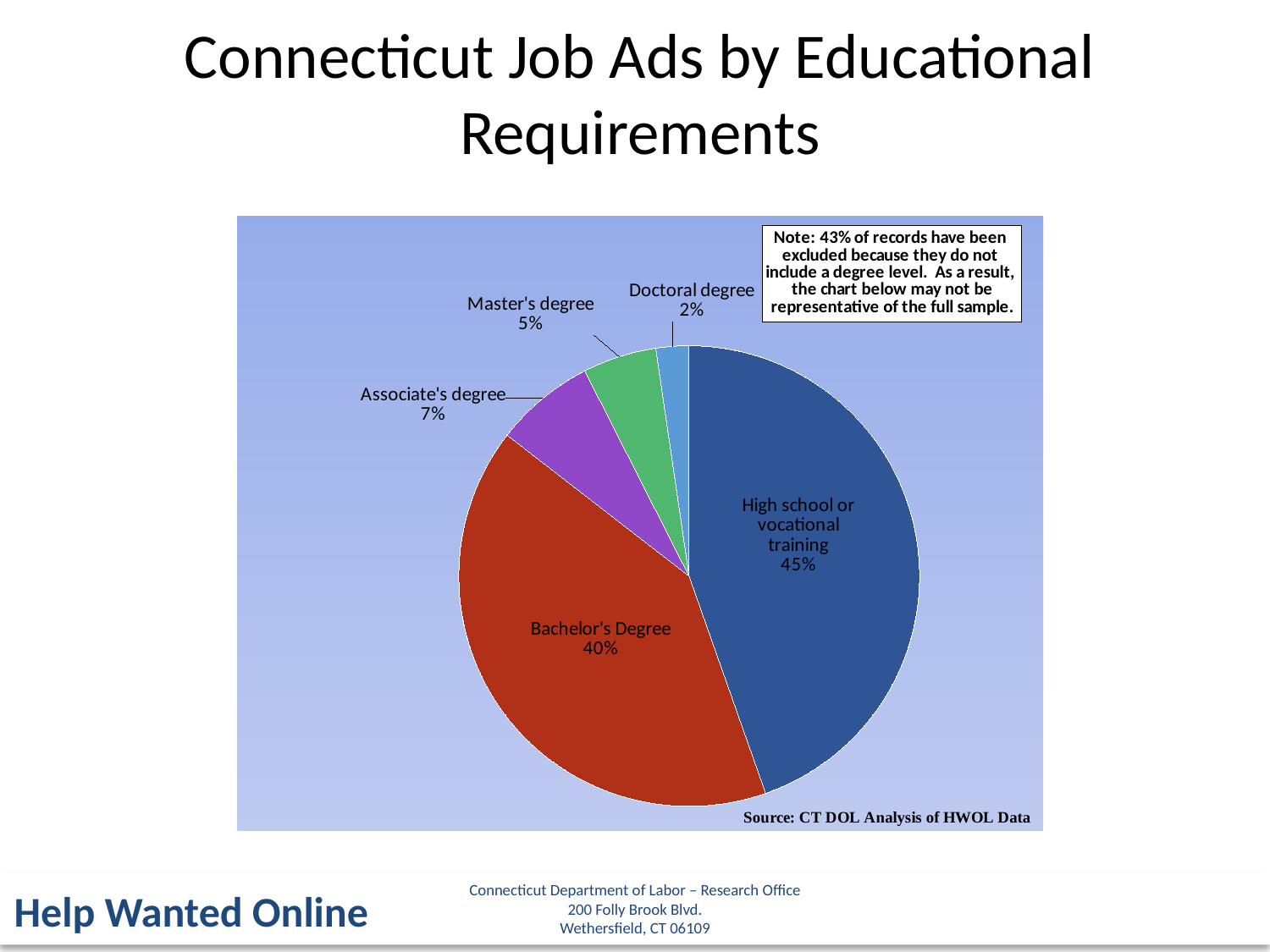
What is the difference in percentage points between the High school or vocational training share and the Bachelor's Degree share? 5 How many educational requirement categories are shown in the pie chart? 5 What share of job ads require high school or vocational training? 45% According to the note on the chart, what percentage of records were excluded because they do not include a degree level? 43% Which educational requirement has the largest share of job ads? High school or vocational training What percentage of job ads require a Master's degree? 5% What share of Connecticut job ads require a Bachelor's Degree? 40% Which educational requirement has the smallest share of job ads? Doctoral degree What is the combined share of job ads requiring an Associate's, Master's or Doctoral degree? 14% What kind of chart is shown on the slide? pie chart Which has a larger share of job ads, Associate's degree or Master's degree? Associate's degree What percentage of job ads require a Doctoral degree? 2%